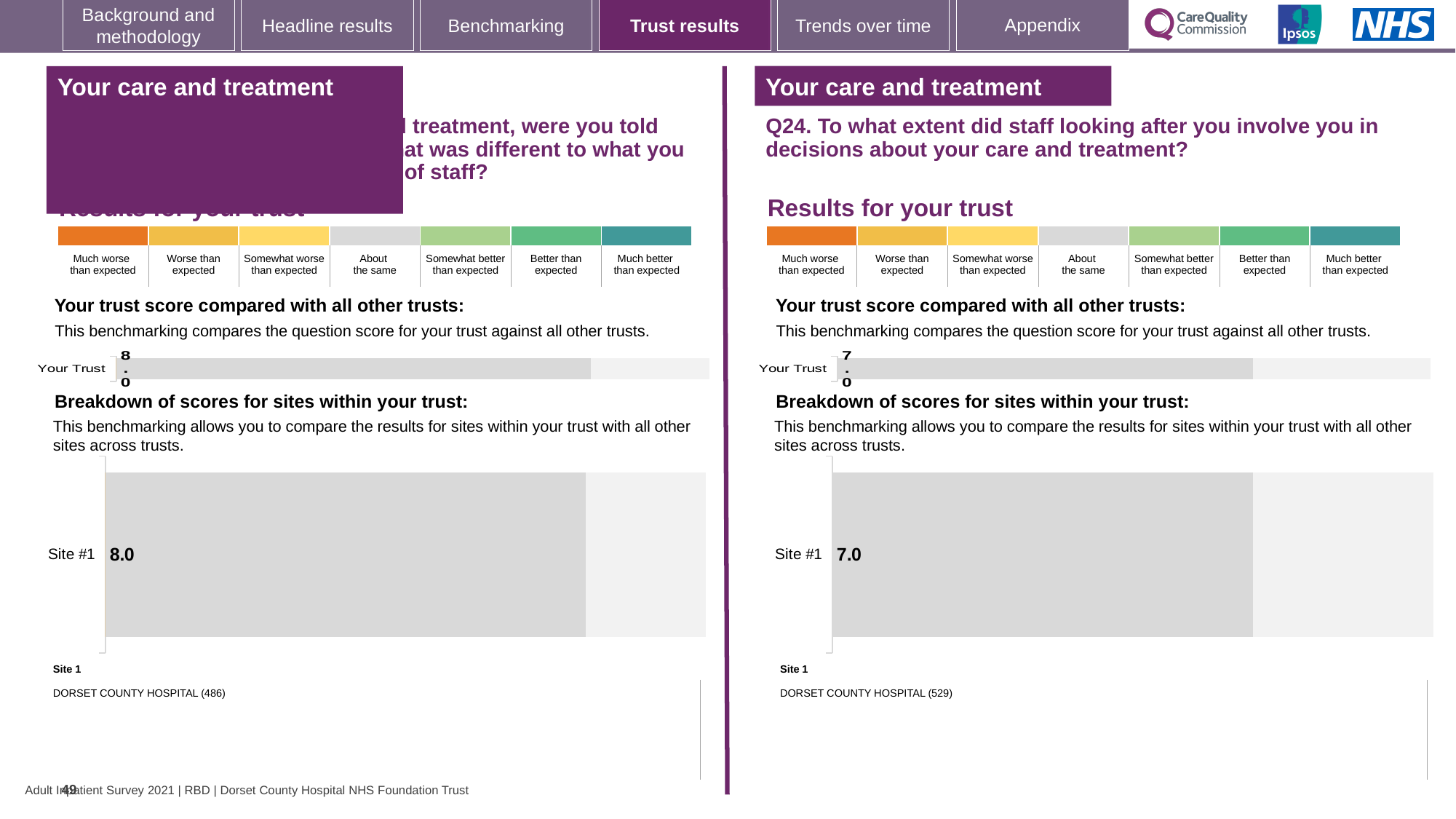
On the left-hand 'Your trust score compared with all other trusts' chart, what is the value for Your Trust? 8.0 On the right-hand 'Your trust score compared with all other trusts' chart for Q24, what is the value for Your Trust? 7.0 On the left-hand chart, what is the score shown for Site #1? 8.0 Which hospital is listed as Site 1 on the right-hand side for Q24? DORSET COUNTY HOSPITAL What is the difference between the Site #1 score on the left-hand chart and the Site #1 score on the right-hand chart for Q24? 1.0 What number is shown in brackets after DORSET COUNTY HOSPITAL on the right-hand side for Q24? 529 What kind of chart is used to show the Site #1 score on the right-hand side for Q24? bar chart How many categories are shown in the colour scale above 'Your trust score compared with all other trusts' on the right-hand side? 7 How many sites are shown in the 'Breakdown of scores for sites within your trust' chart on the right-hand side for Q24? 1 On the right-hand chart for Q24, what is the score shown for Site #1? 7.0 Which Site #1 score is larger: the one on the left-hand chart or the one on the right-hand chart for Q24? the left-hand chart